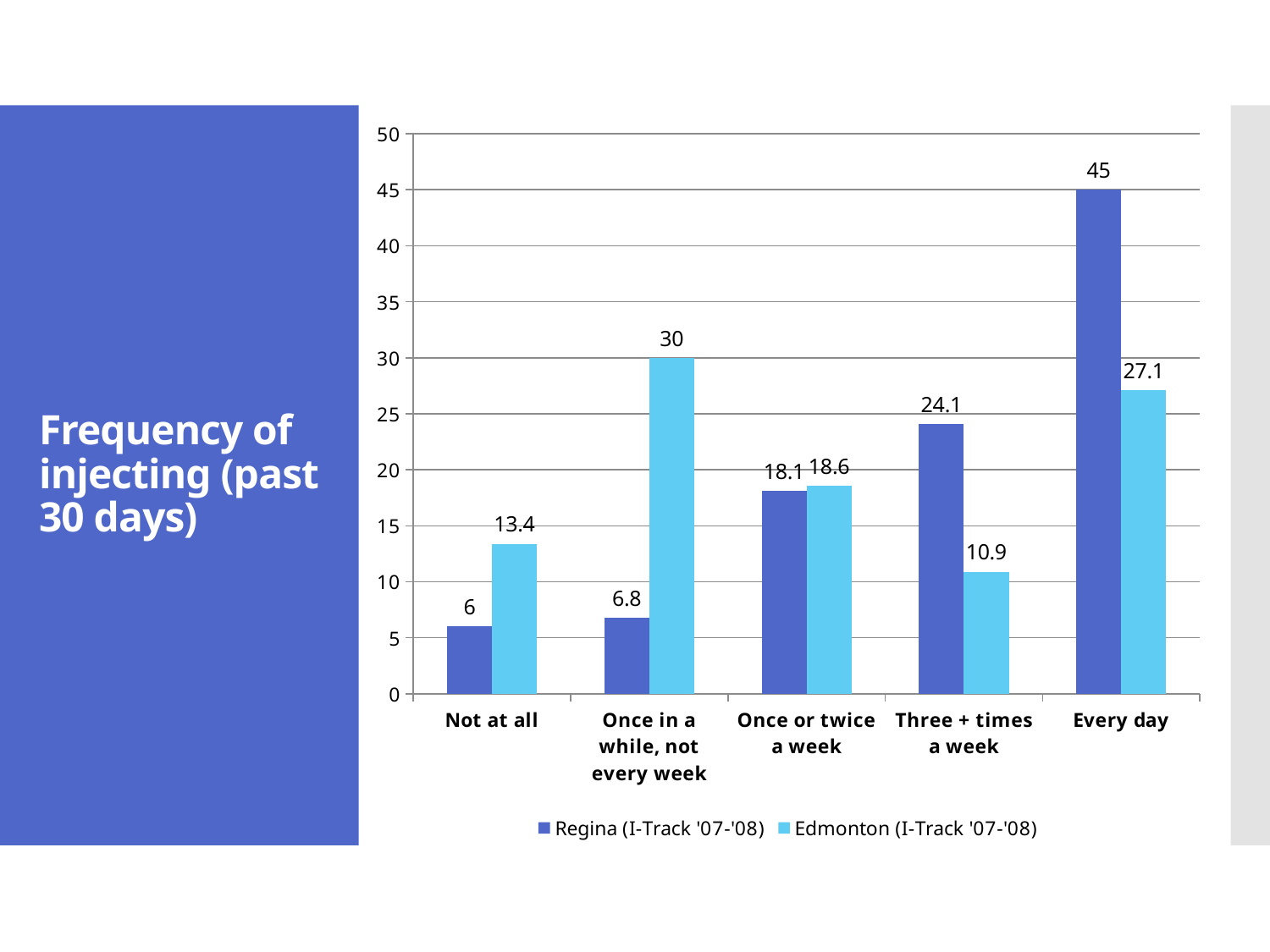
What is the value for Regina (I-Track '07-'08) in the Every day category? 45 Which is larger in the Three + times a week category: Regina (I-Track '07-'08) or Edmonton (I-Track '07-'08)? Regina (I-Track '07-'08) What is the title of the slide? Frequency of injecting (past 30 days) What kind of chart is shown on the slide? Bar chart How many categories are shown on the x axis? 5 What is the difference between the Regina and Edmonton values in the Every day category? 17.9 Which category has the highest value for Regina (I-Track '07-'08)? Every day What is the difference between the Edmonton and Regina values in the Not at all category? 7.4 Which category has the lowest value for Edmonton (I-Track '07-'08)? Three + times a week How many series does the legend list? 2 What is the value for Edmonton (I-Track '07-'08) in the Three + times a week category? 10.9 What is the value for Edmonton (I-Track '07-'08) in the Once in a while, not every week category? 30